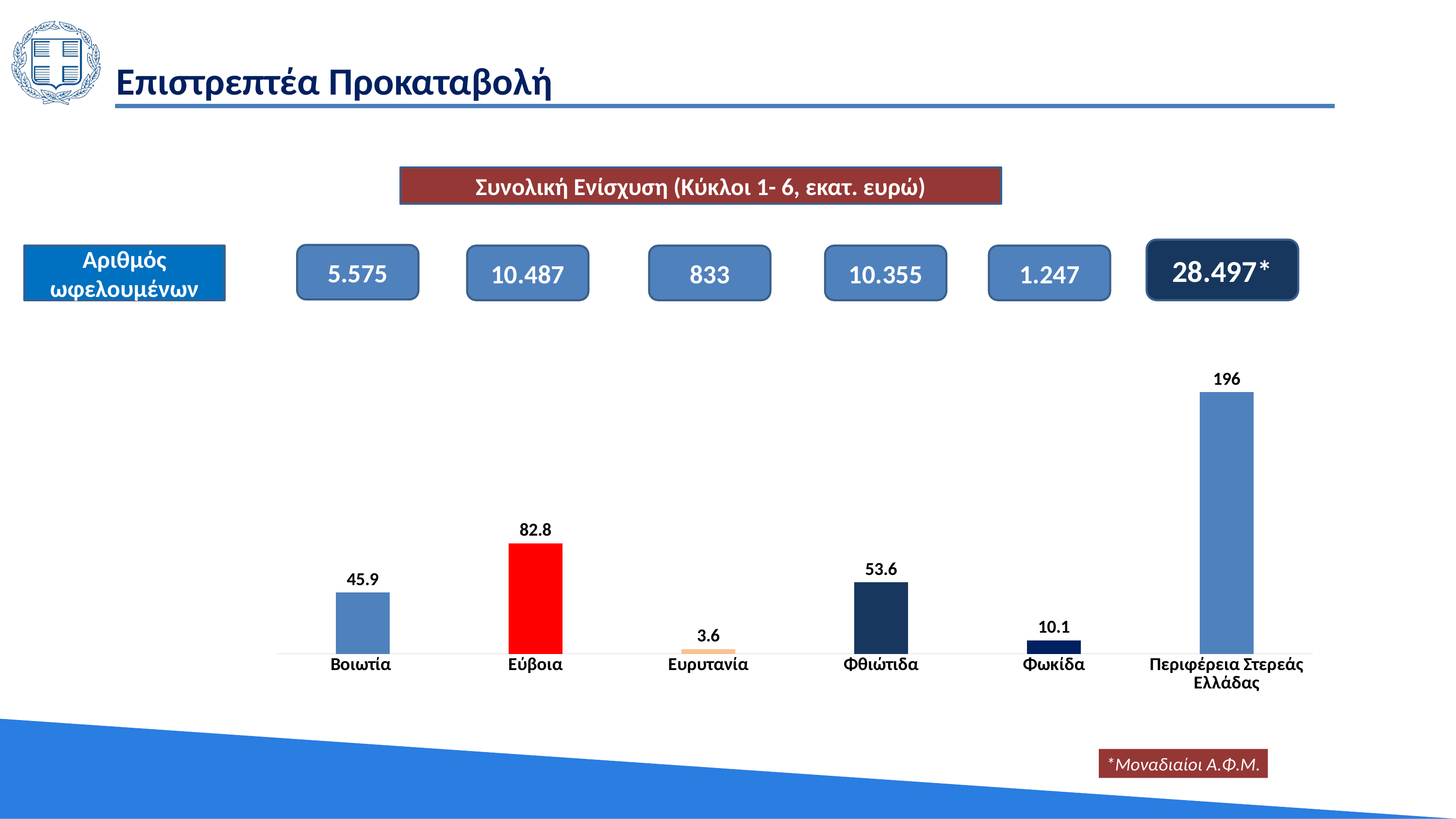
Which category has the lowest value in the chart? Ευρυτανία What is the value for Εύβοια in the chart? 82.8 What is the value for Ευρυτανία in the chart? 3.6 What is the title of the chart? Συνολική Ενίσχυση (Κύκλοι 1- 6, εκατ. ευρώ) What is the value for Περιφέρεια Στερεάς Ελλάδας in the chart? 196 How many categories are shown in the chart? 6 What kind of chart is shown on the slide? Bar chart What is the difference between the values for Εύβοια and Βοιωτία? 36.9 Which is larger, the value for Βοιωτία or the value for Φθιώτιδα? Φθιώτιδα Which category has the highest value in the chart? Περιφέρεια Στερεάς Ελλάδας What is the difference between the values for Φθιώτιδα and Φωκίδα? 43.5 What is the value for Φθιώτιδα in the chart? 53.6